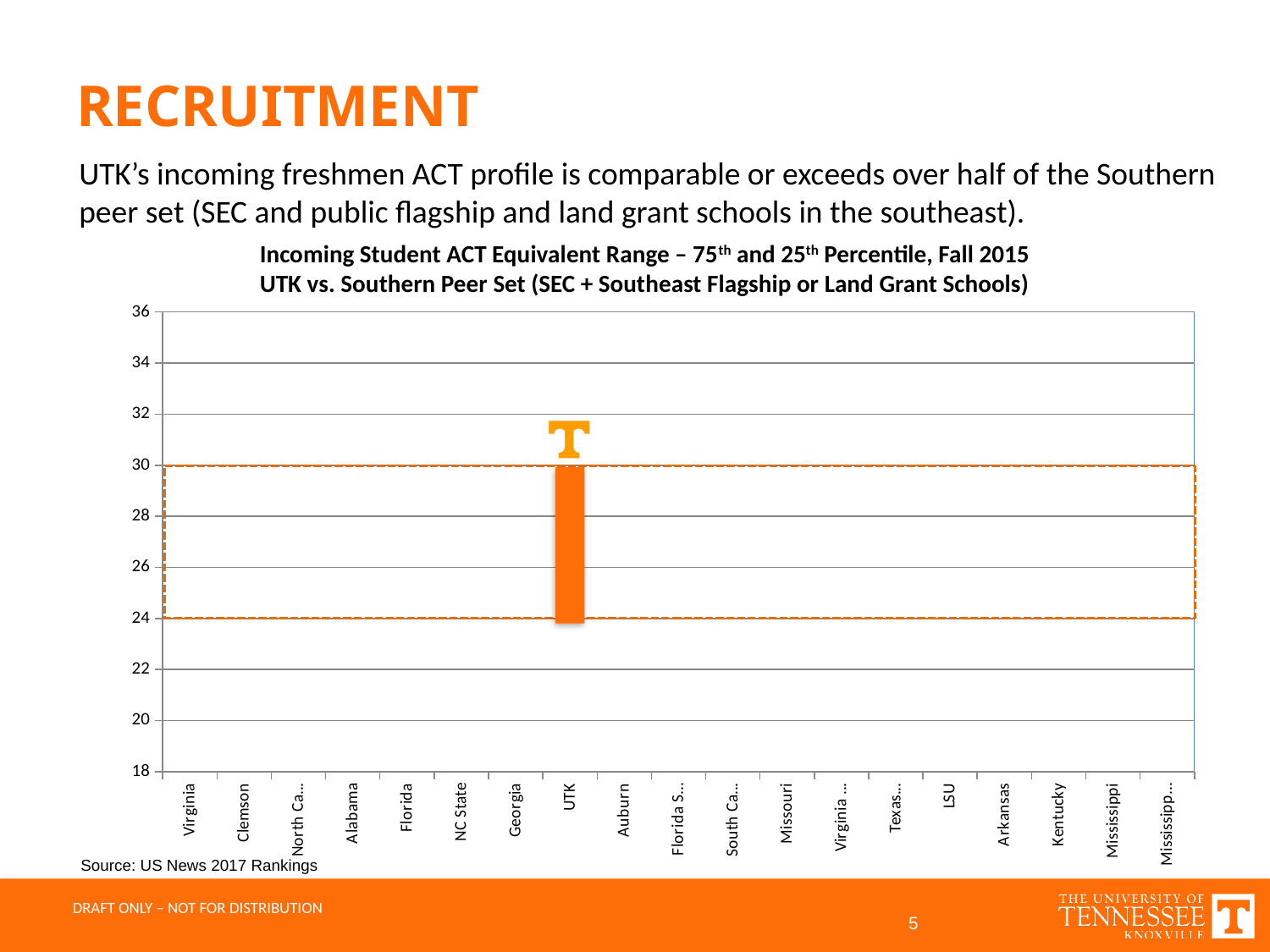
What is the upper (75th percentile) value of the UTK bar? 30 What is the lowest value shown on the y axis? 18 Which school is the only one with a bar plotted on the chart? UTK Is the bottom of the UTK bar greater or less than 26? less Which school's label appears first on the x axis? Virginia What kind of chart is shown on the slide? bar chart What is the lower (25th percentile) value of the UTK bar? 24 What source is cited below the chart? US News 2017 Rankings How many schools are listed along the x axis of the chart? 19 What is the difference between the top and bottom of the UTK bar? 6 Is the top of the UTK bar greater or less than 28? greater What is the highest value shown on the y axis? 36